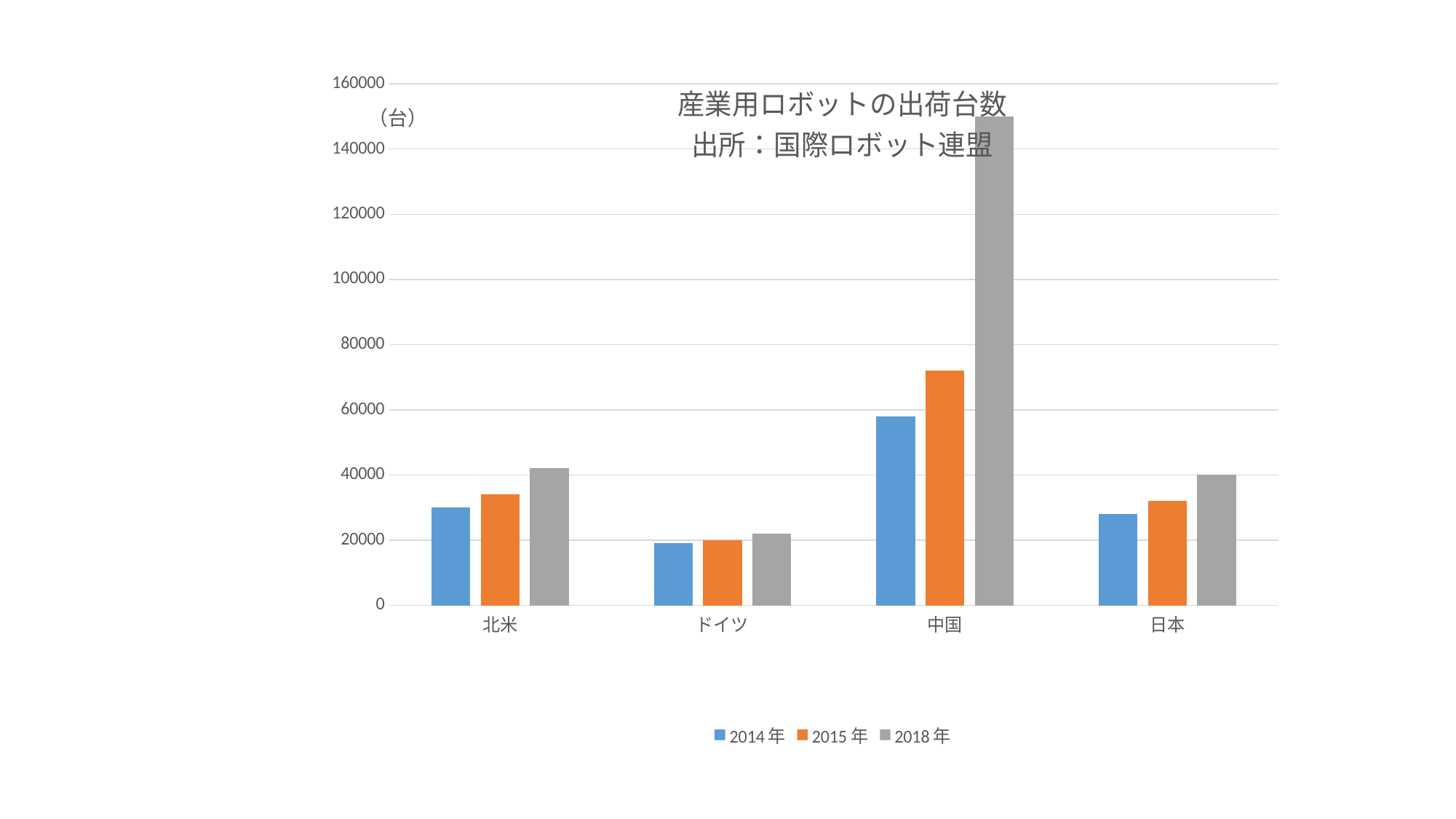
What is the title of the chart? 産業用ロボットの出荷台数 出所：国際ロボット連盟 Which category has the lowest value for 2014年? ドイツ Is the value for 中国 in 2018年 greater or less than 140000? greater Is the value for 中国 in 2015年 greater or less than 60000? greater Which category has the lowest value for 2018年? ドイツ What kind of chart is shown on the slide? bar chart Which category has the highest value for 2018年? 中国 Which is larger, the 2014年 value for 中国 or the 2014年 value for 北米? 中国 How many series does the legend list? 3 For 中国, do the values rise or fall from 2014年 to 2018年? rise How many categories are shown on the x axis? 4 Is the value for 北米 in 2014年 greater or less than 20000? greater